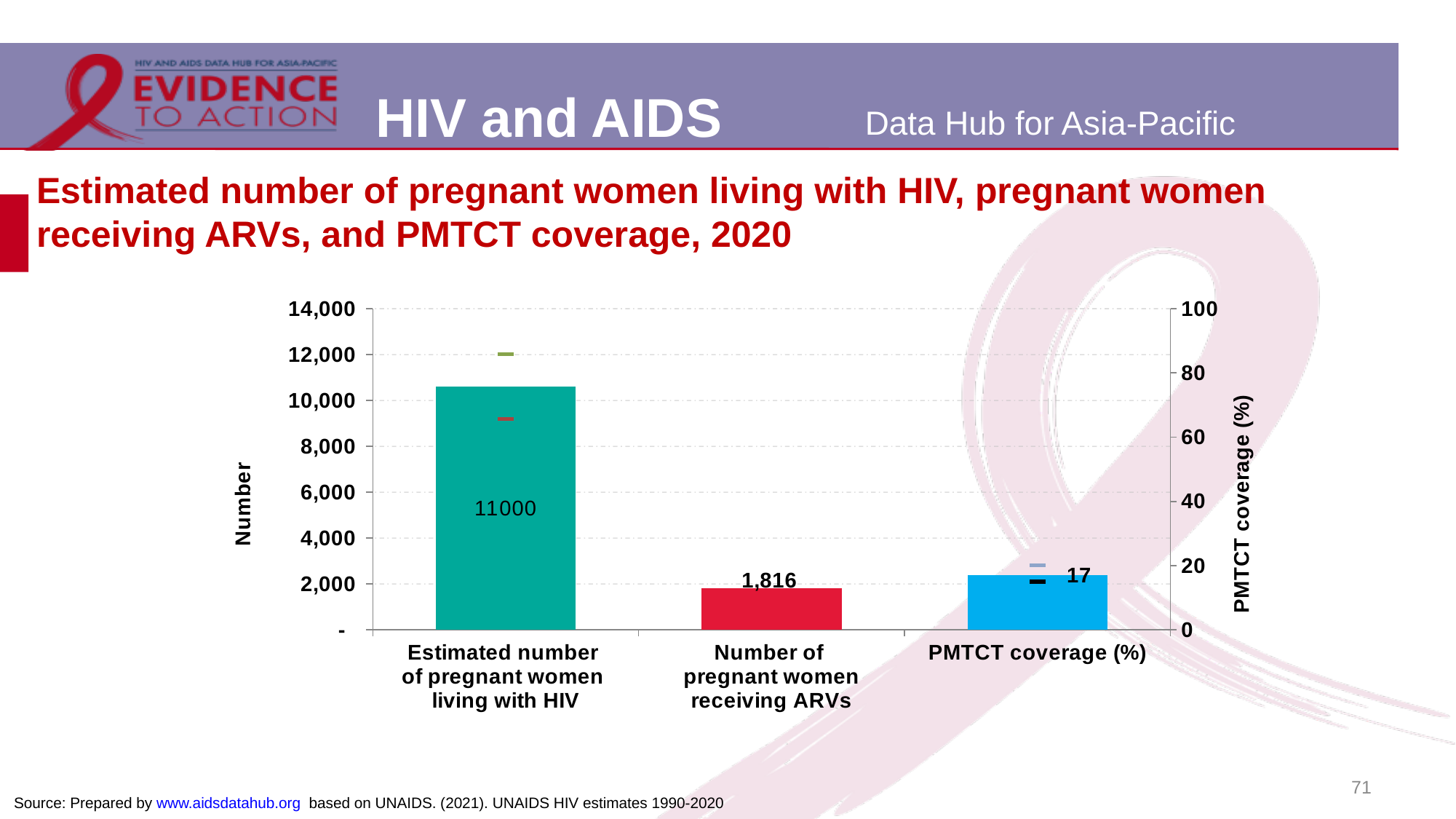
How many categories are shown on the x axis of the chart? 3 What is the label of the right vertical axis of the chart? PMTCT coverage (%) What is the value shown for PMTCT coverage (%)? 17 Is the bar for the estimated number of pregnant women living with HIV greater or less than 10,000 on the left axis? greater Which is larger: the estimated number of pregnant women living with HIV or the number of pregnant women receiving ARVs? Estimated number of pregnant women living with HIV What is the data label shown on the bar for the estimated number of pregnant women living with HIV? 11000 What kind of chart is shown on the slide? Bar chart What is the label of the left vertical axis of the chart? Number Is the bar for the number of pregnant women receiving ARVs greater or less than 4,000 on the left axis? less What is the difference between the estimated number of pregnant women living with HIV (11000) and the number of pregnant women receiving ARVs (1,816)? 9,184 Which category has the tallest bar on the chart? Estimated number of pregnant women living with HIV What is the value shown for the number of pregnant women receiving ARVs? 1,816